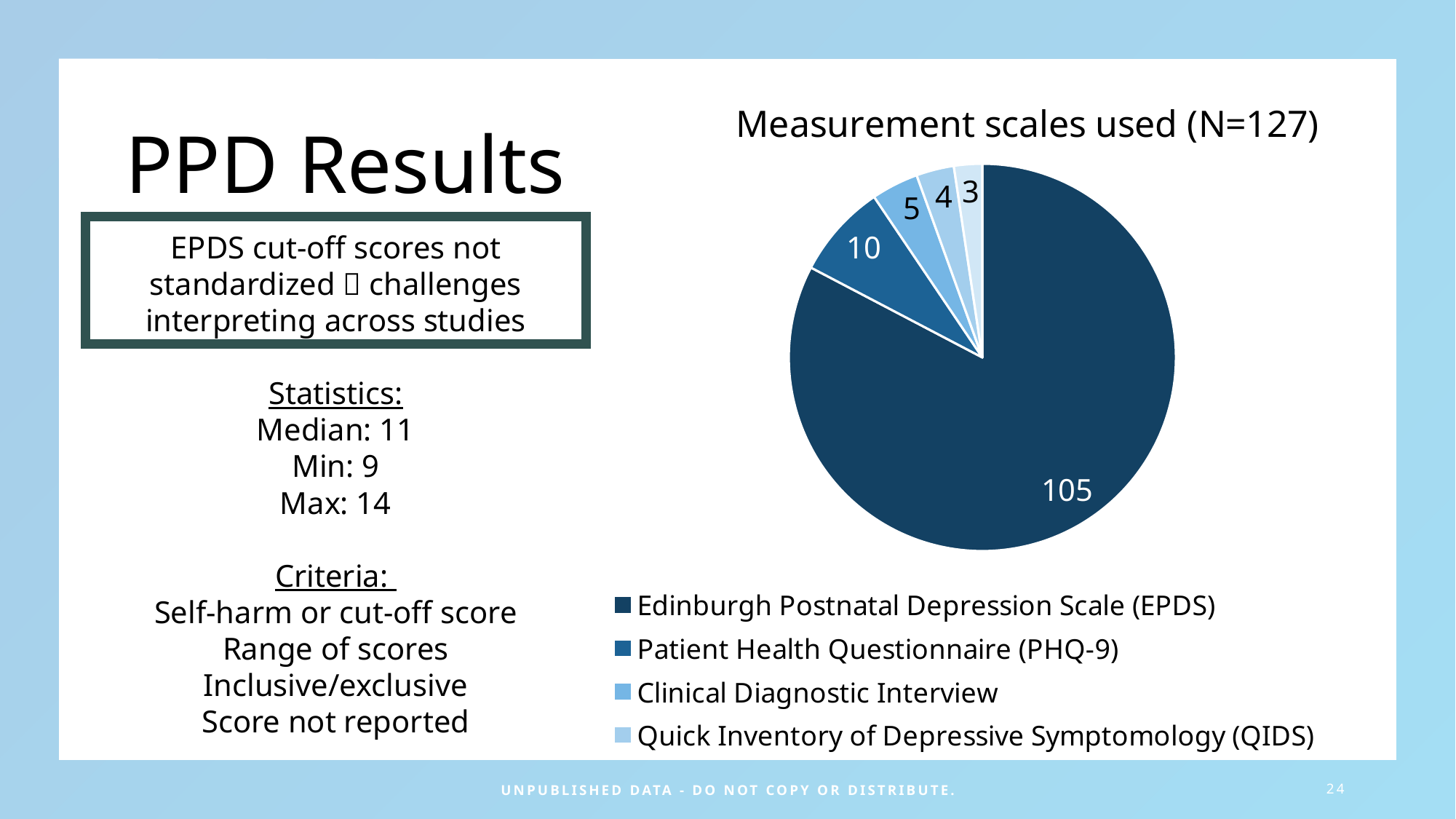
Which is larger, the PHQ-9 slice or the Clinical Diagnostic Interview slice? Patient Health Questionnaire (PHQ-9) What is the value for the Clinical Diagnostic Interview slice? 5 How many studies used the Edinburgh Postnatal Depression Scale (EPDS)? 105 How many slices does the pie chart have? 5 What is the value for the Quick Inventory of Depressive Symptomology (QIDS) slice? 4 Which measurement scale has the largest slice of the pie? Edinburgh Postnatal Depression Scale (EPDS) What type of chart is shown on the slide? Pie chart What is the title of the chart? Measurement scales used (N=127) What is the difference between the EPDS value and the PHQ-9 value? 95 Which of the legend-listed scales has the smallest slice? Quick Inventory of Depressive Symptomology (QIDS) How many entries does the chart legend list? 4 What is the value for the Patient Health Questionnaire (PHQ-9) slice? 10